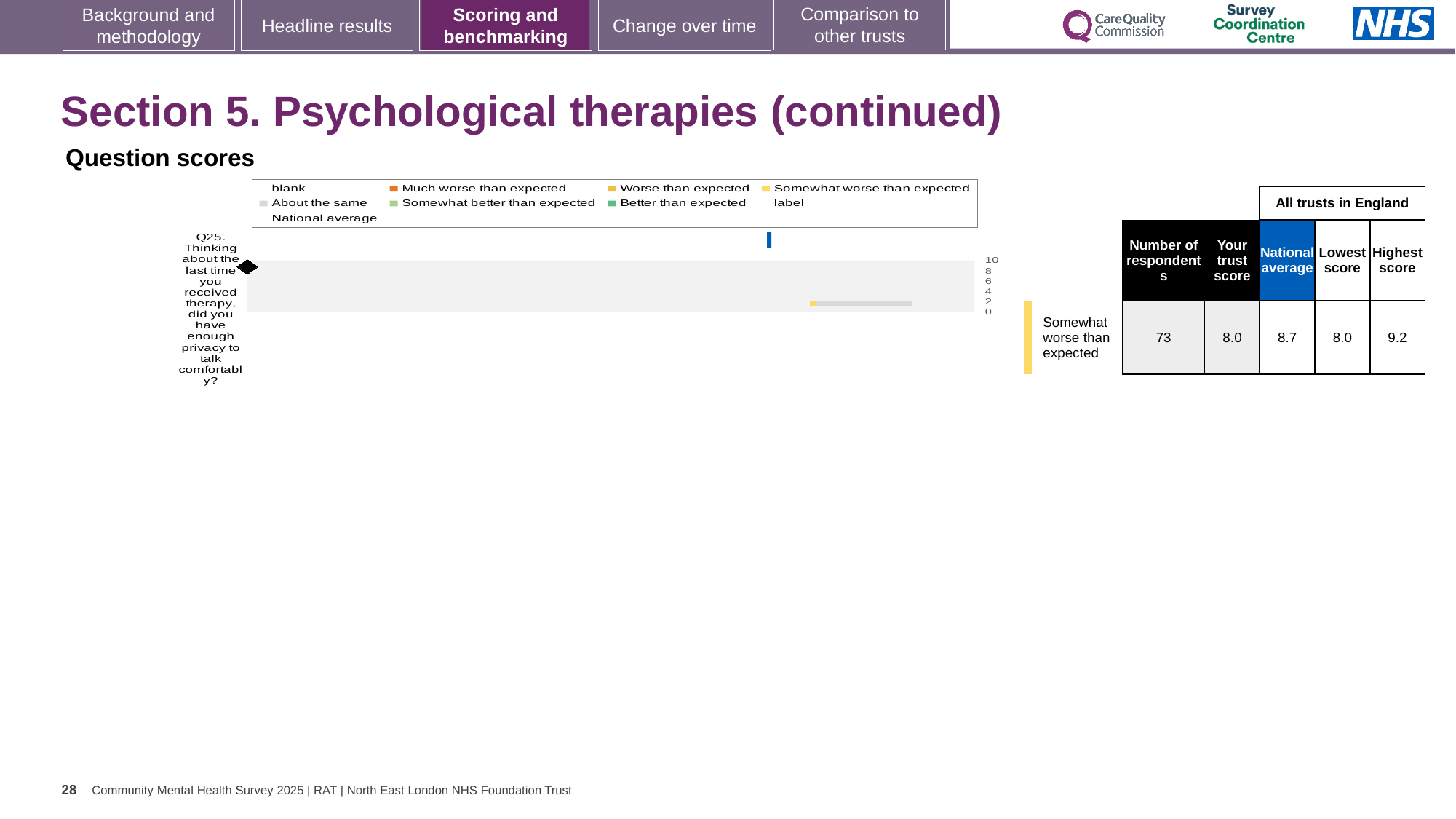
What is the highest value shown on the chart's axis? 10 What is the lowest score among all trusts in England for Q25? 8.0 What kind of chart is shown under 'Question scores'? bar chart How many survey questions are plotted in the chart? 1 Which question is plotted in the chart? Q25. Thinking about the last time you received therapy, did you have enough privacy to talk comfortably? What is the difference between the national average and the trust score for Q25? 0.7 What is the trust score for Q25? 8.0 What is the highest score among all trusts in England for Q25? 9.2 What is the national average for Q25? 8.7 How many respondents answered Q25? 73 What benchmark category is shown for Q25? Somewhat worse than expected Which is larger for Q25, the trust score or the national average? national average